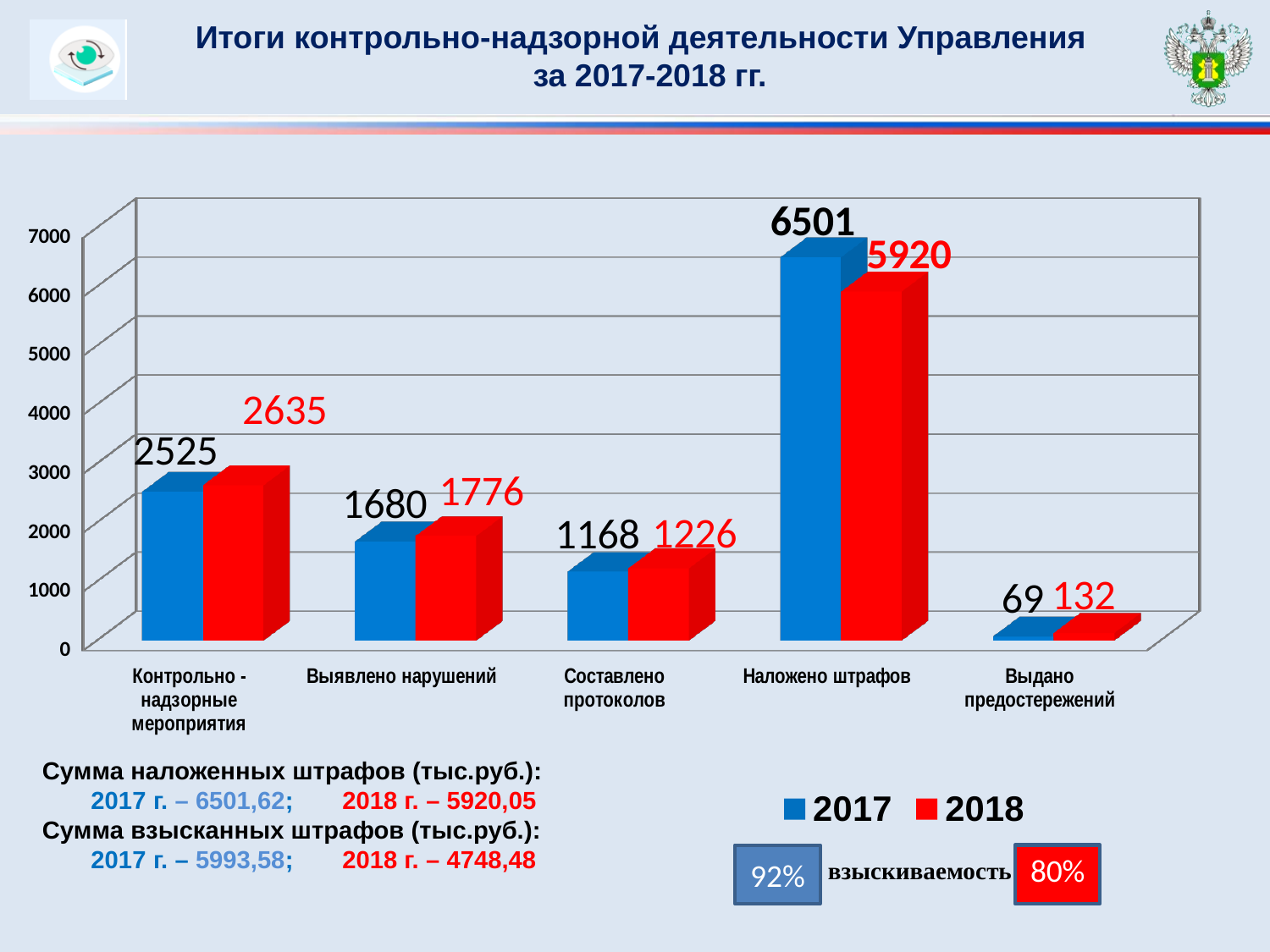
How many series does the legend list? 2 What is the 2018 value for Выявлено нарушений? 1776 Which is larger for Составлено протоколов: the 2017 value or the 2018 value? 2018 Which category has the highest 2017 value? Наложено штрафов What is the 2017 value for Контрольно-надзорные мероприятия? 2525 What is the 2018 value for Выдано предостережений? 132 What kind of chart is shown on the slide? Bar chart What is the difference between the 2018 and 2017 values for Контрольно-надзорные мероприятия? 110 How many categories are shown on the x axis? 5 Which category has the lowest 2018 value? Выдано предостережений What is the difference between the 2017 and 2018 values for Наложено штрафов? 581 Which colour represents the 2018 series in the chart? Red